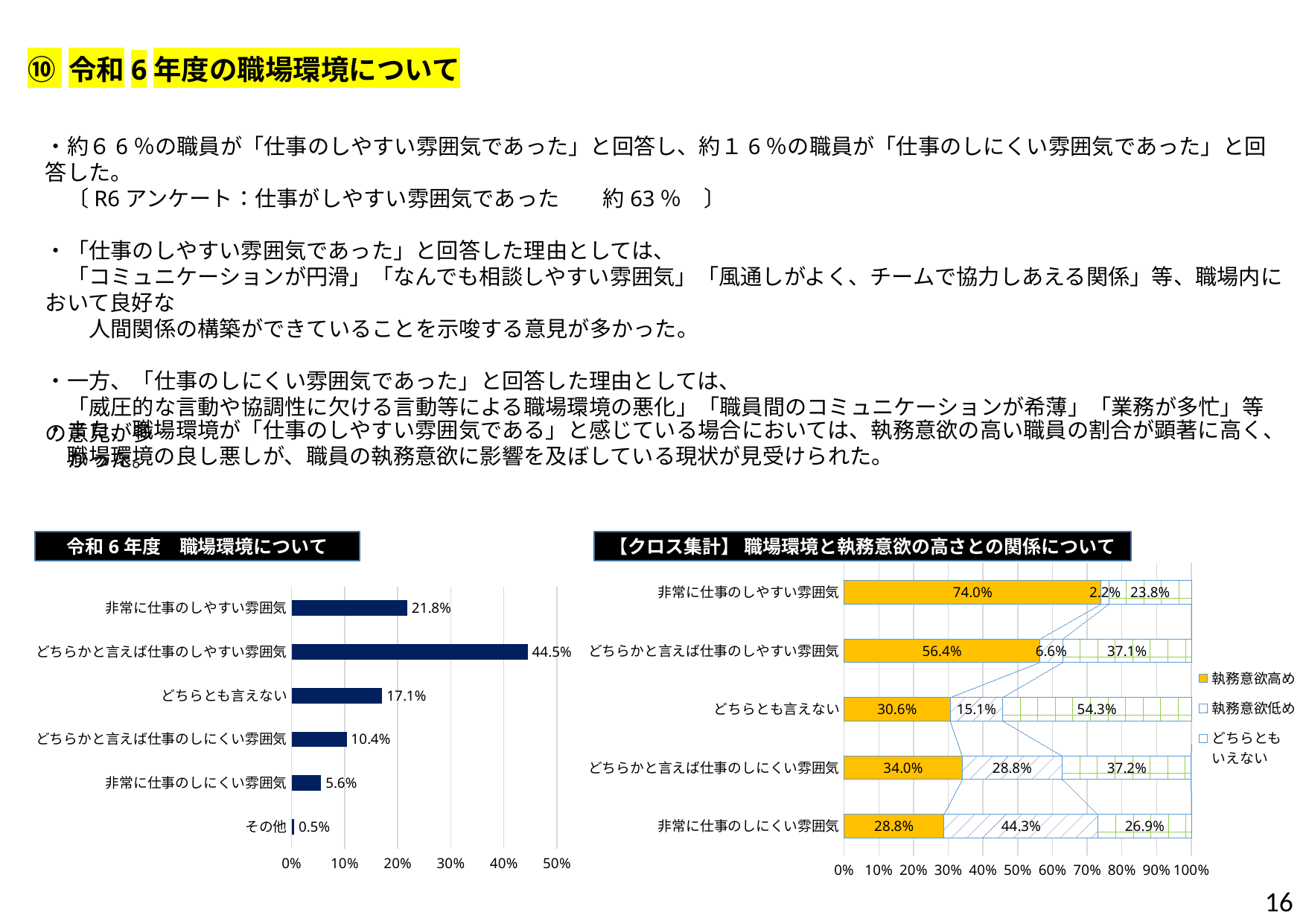
In the chart titled 令和6年度 職場環境について, which category has the lowest value? その他 In the chart titled 【クロス集計】職場環境と執務意欲の高さとの関係について, is the どちらともいえない value for どちらとも言えない larger or smaller than the どちらともいえない value for 非常に仕事のしやすい雰囲気? Larger In the chart titled 【クロス集計】職場環境と執務意欲の高さとの関係について, what is the 執務意欲低め value for 非常に仕事のしにくい雰囲気? 44.3% In the chart titled 令和6年度 職場環境について, what is the value for どちらかと言えば仕事のしやすい雰囲気? 44.5% In the chart titled 令和6年度 職場環境について, what is the difference between 非常に仕事のしやすい雰囲気 and 非常に仕事のしにくい雰囲気? 16.2% In the chart titled 令和6年度 職場環境について, which category has the highest value? どちらかと言えば仕事のしやすい雰囲気 In the chart titled 【クロス集計】職場環境と執務意欲の高さとの関係について, how many series does the legend list? 3 In the chart titled 【クロス集計】職場環境と執務意欲の高さとの関係について, what is the 執務意欲高め value for 非常に仕事のしやすい雰囲気? 74.0% What kind of chart is the chart titled 令和6年度 職場環境について? Bar chart In the chart titled 【クロス集計】職場環境と執務意欲の高さとの関係について, what is the difference between the 執務意欲高め values for 非常に仕事のしやすい雰囲気 and どちらかと言えば仕事のしやすい雰囲気? 17.6% In the chart titled 【クロス集計】職場環境と執務意欲の高さとの関係について, which category has the highest 執務意欲高め value? 非常に仕事のしやすい雰囲気 In the chart titled 令和6年度 職場環境について, how many categories are shown? 6